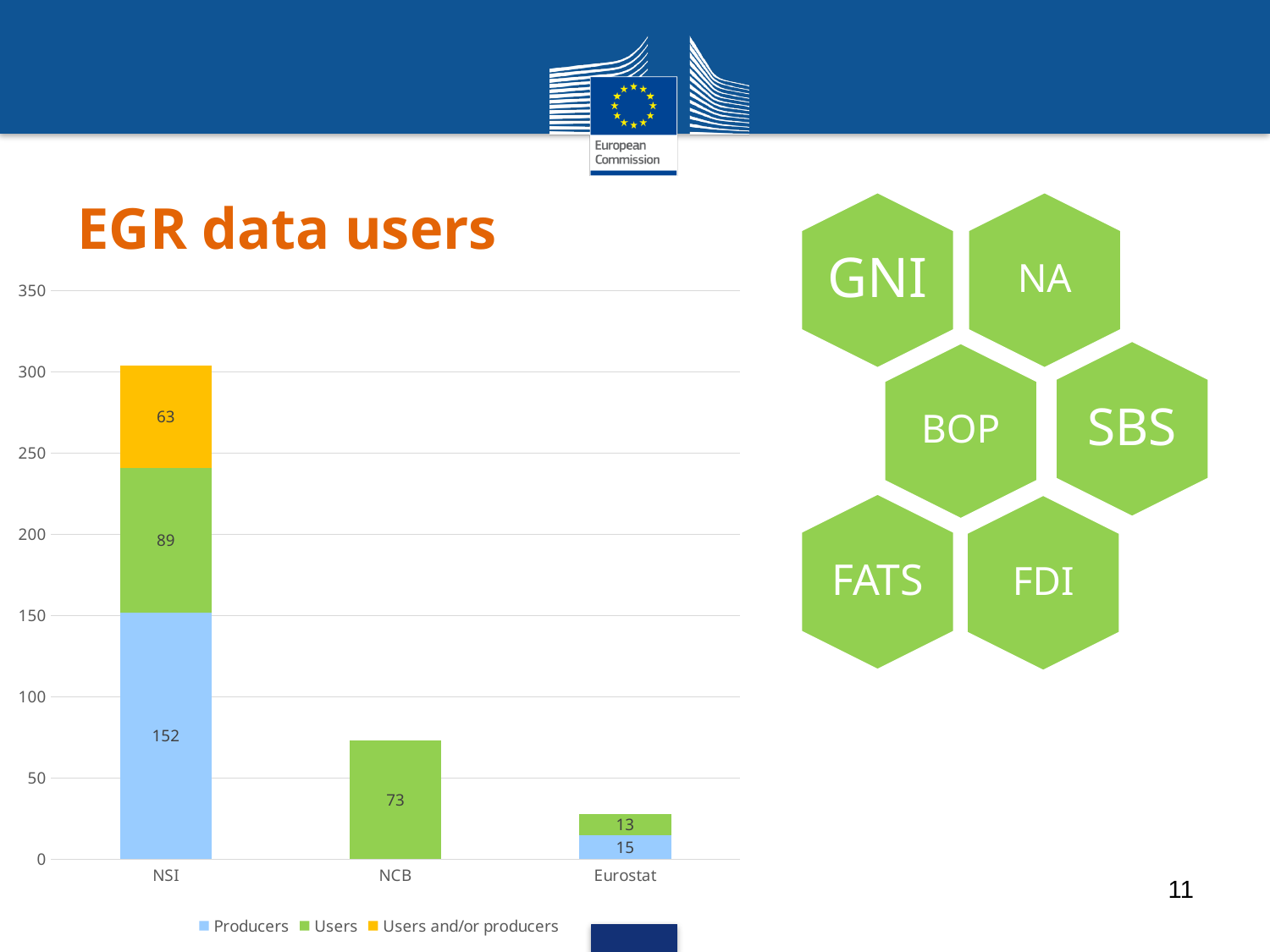
What is the total of the stacked bar for NSI? 304 What is the difference between the Users value for NSI and the Users value for NCB? 16 What is the Producers value for Eurostat? 15 What is the total of the stacked bar for Eurostat? 28 Which category has the shortest stacked bar? Eurostat What is the Producers value for NSI? 152 Which is larger, the Users value for NSI or the Users value for Eurostat? NSI What is the Users value for NCB? 73 What is the Users and/or producers value for NSI? 63 Which category has the tallest stacked bar? NSI What kind of chart is shown on the slide? Stacked bar chart How many series does the legend list? 3